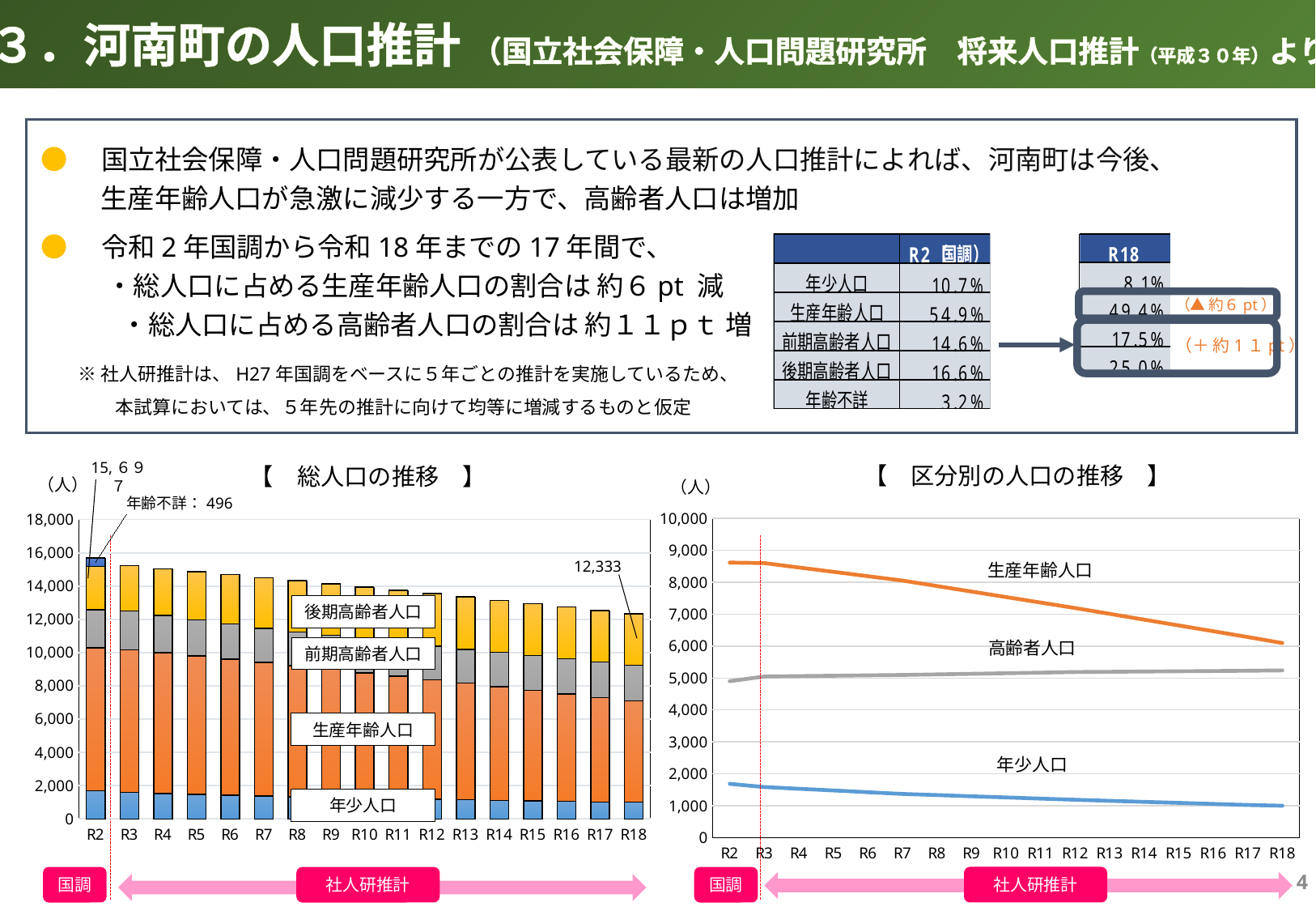
In the 総人口の推移 chart, what is the difference between the labelled totals for R2 and R18? 3,364 In the 区分別の人口の推移 chart, which is larger at R18, 高齢者人口 or 年少人口? 高齢者人口 In the 区分別の人口の推移 chart, is the value of 生産年齢人口 at R18 greater or less than 7,000? less In the 総人口の推移 chart, how many years (bars) are shown on the x axis? 17 What kind of chart is the 総人口の推移 chart on the left? bar chart In the 区分別の人口の推移 chart, does the 生産年齢人口 line rise or fall from R2 to R18? fall In the 区分別の人口の推移 chart, which line is the highest across all years? 生産年齢人口 In the 総人口の推移 chart, what is the total population labelled for R18? 12,333 In the 総人口の推移 chart, what is the total population labelled for R2? 15,697 In the 区分別の人口の推移 chart, how many lines are plotted? 3 What kind of chart is the 区分別の人口の推移 chart on the right? line chart In the 総人口の推移 chart, what is the labelled value of 年齢不詳 for R2? 496